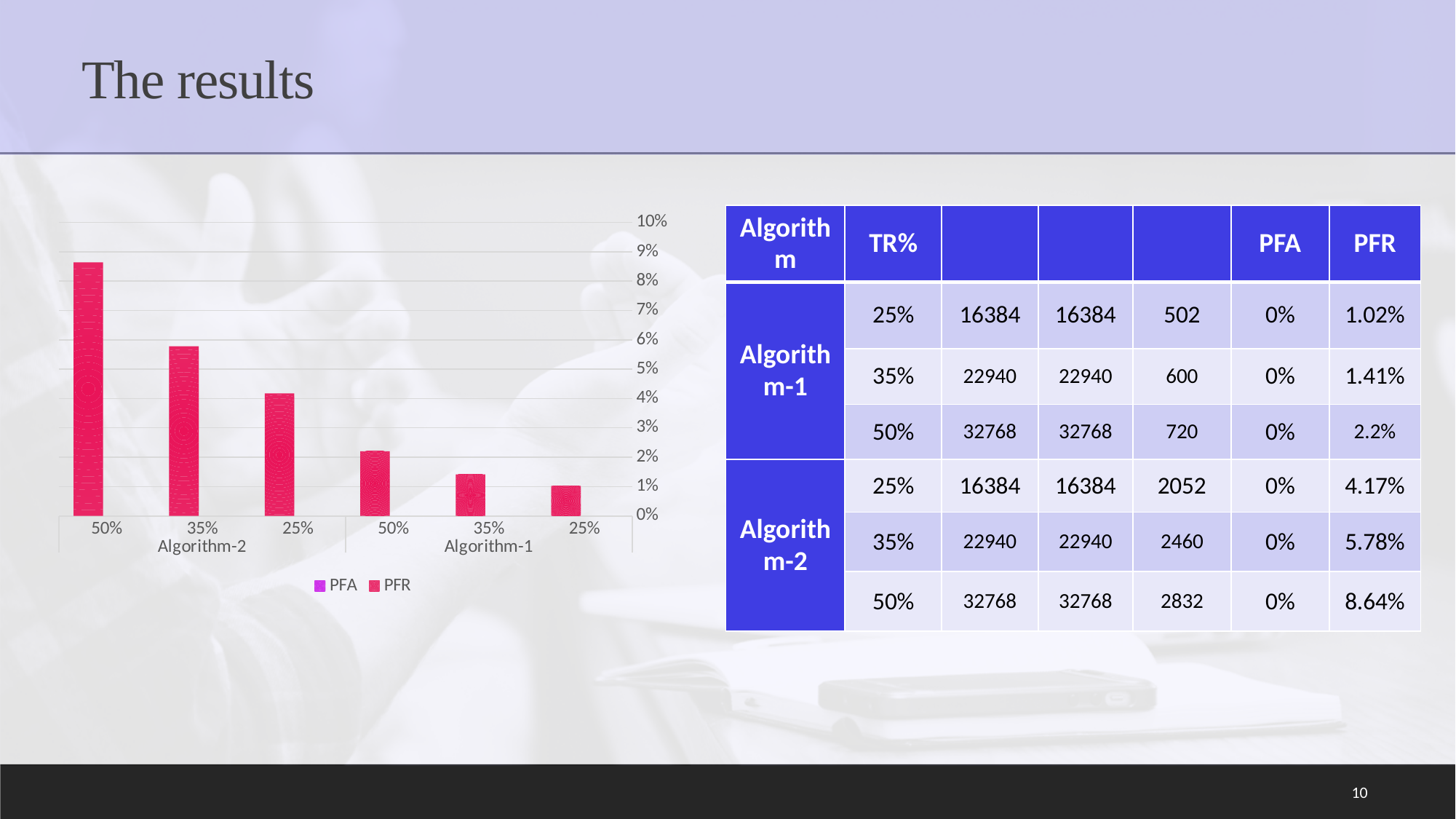
What is the highest value shown on the chart's vertical axis? 10% How many bars are plotted in the chart? 6 Is the PFR bar for Algorithm-2 at 50% greater or less than 8%? greater Is the PFR bar for Algorithm-2 at 35% greater or less than 5%? greater What are the two series named in the chart legend? PFA and PFR How many series does the chart legend list? 2 Which is larger in the chart: the PFR bar for Algorithm-2 at 25% or the PFR bar for Algorithm-1 at 50%? Algorithm-2 at 25% Is the PFR bar for Algorithm-1 at 50% greater or less than 3%? less Which category has the lowest PFR bar in the chart? Algorithm-1 at 25% Do the PFR bars rise or fall from left to right across the chart? fall Which algorithm group has the tallest PFR bar in the chart? Algorithm-2 What kind of chart is shown on the left of the slide? bar chart